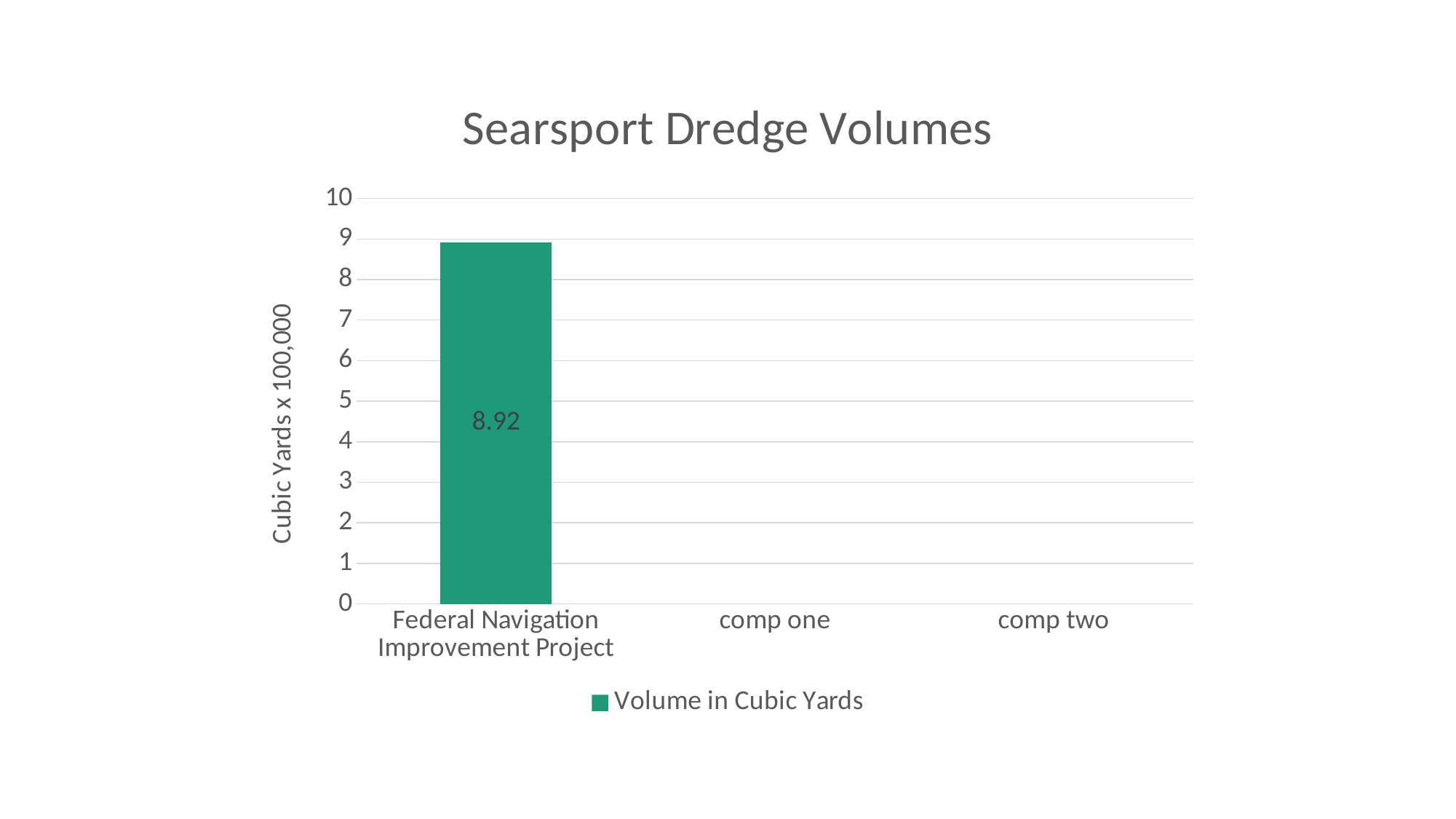
What is the title of the chart? Searsport Dredge Volumes How many categories have a visible bar? 1 Is the value for Federal Navigation Improvement Project greater or less than 8? greater What is the value for Federal Navigation Improvement Project? 8.92 What is the label of the y axis? Cubic Yards x 100,000 Which category has the highest value? Federal Navigation Improvement Project How many categories are shown on the x axis? 3 Is the value for Federal Navigation Improvement Project greater or less than 9? less How many series does the legend list? 1 What kind of chart is this? bar chart